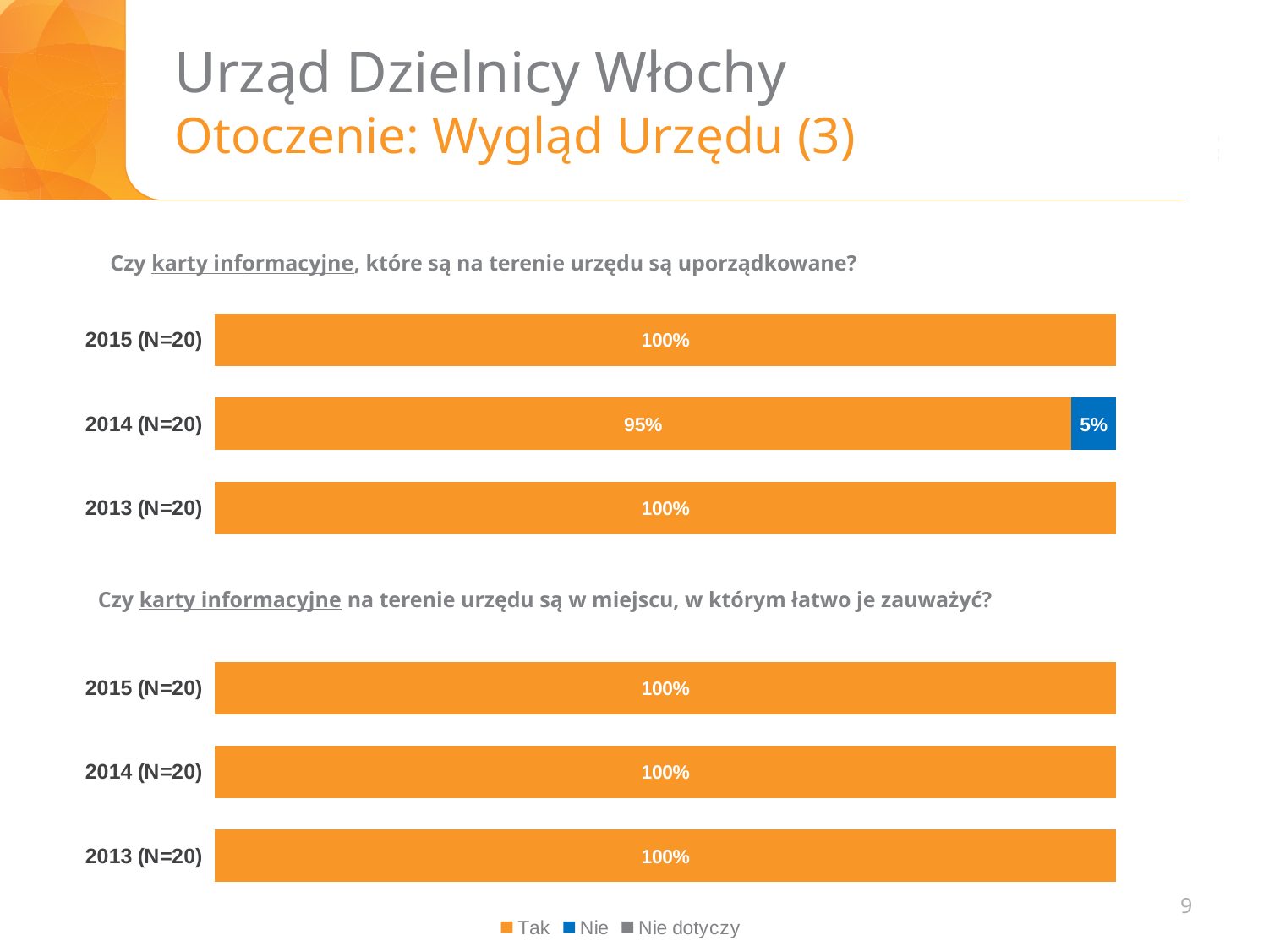
In the bottom chart ("Czy karty informacyjne na terenie urzędu są w miejscu, w którym łatwo je zauważyć?"), what is the value for Tak in 2013 (N=20)? 100% In the top chart ("Czy karty informacyjne, które są na terenie urzędu są uporządkowane?"), what is the total of the 2014 (N=20) bar? 100% How many series does the legend at the bottom of the slide list? 3 What kind of chart is the top chart on the slide? Stacked horizontal bar chart In the top chart ("Czy karty informacyjne, które są na terenie urzędu są uporządkowane?"), is the Tak value for 2014 (N=20) larger or smaller than the Tak value for 2013 (N=20)? Smaller In the top chart ("Czy karty informacyjne, które są na terenie urzędu są uporządkowane?"), what is the difference between the Tak value in 2015 and the Tak value in 2014? 5% In the top chart ("Czy karty informacyjne, które są na terenie urzędu są uporządkowane?"), what is the value for Tak in 2014 (N=20)? 95% In the bottom chart ("Czy karty informacyjne na terenie urzędu są w miejscu, w którym łatwo je zauważyć?"), how many years are shown? 3 Which colour represents the Nie series in the legend? Blue In the top chart ("Czy karty informacyjne, które są na terenie urzędu są uporządkowane?"), what is the value for Nie in 2014 (N=20)? 5% In the top chart ("Czy karty informacyjne, które są na terenie urzędu są uporządkowane?"), which year has the lowest Tak value? 2014 (N=20) In the top chart ("Czy karty informacyjne, które są na terenie urzędu są uporządkowane?"), what is the value for Tak in 2015 (N=20)? 100%